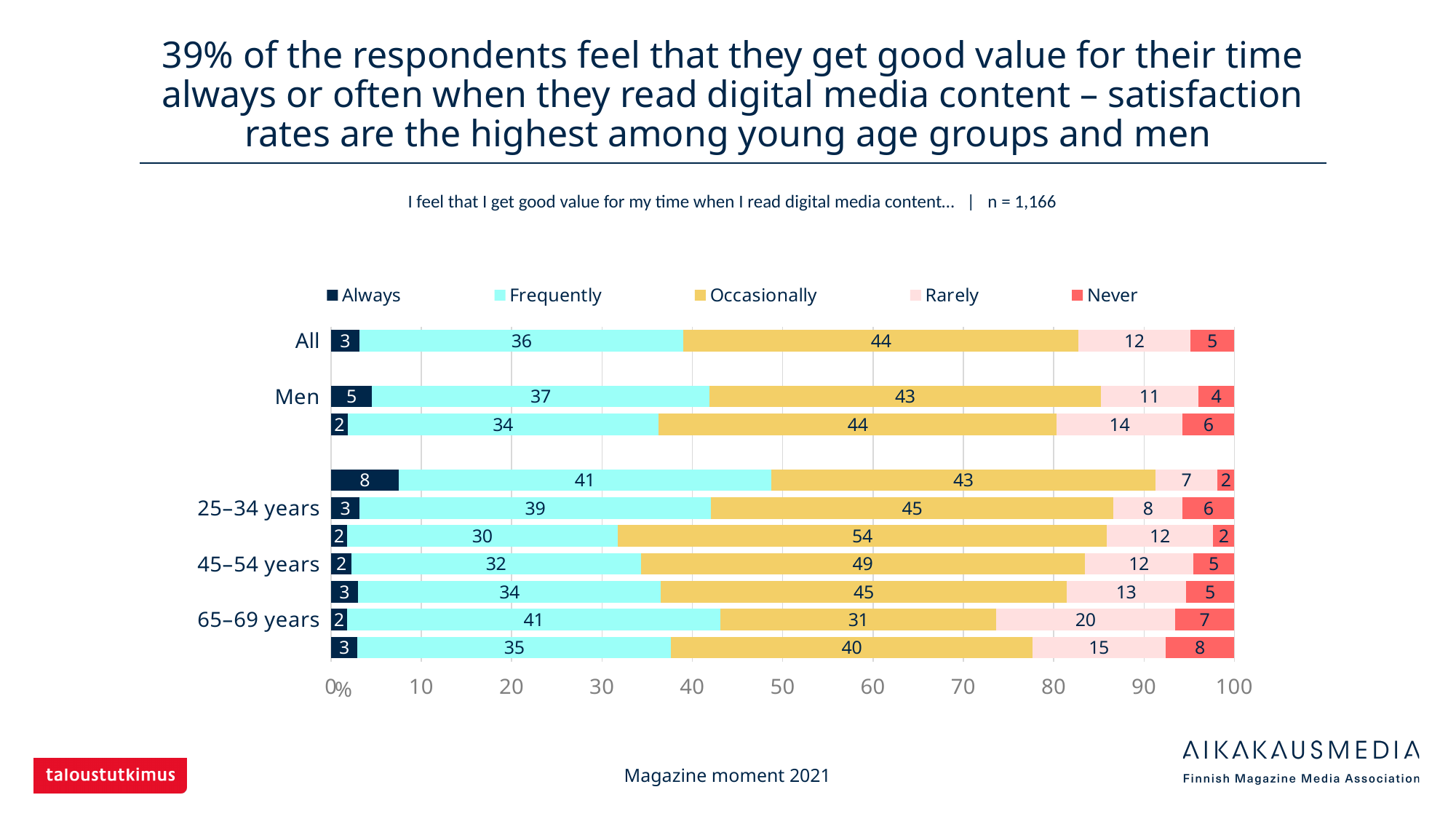
How many series does the legend list? 5 What is the value of the Always segment for Men? 5 What is the difference between the Occasionally values for 45–54 years and 65–69 years? 18 What is the value of the Never segment for 45–54 years? 5 What is the value of the Frequently segment for 25–34 years? 39 Which bar has the highest Rarely value? 65–69 years What is the value of the Rarely segment for 65–69 years? 20 What kind of chart is shown on the slide? Stacked bar chart What colour represents the Never series in the legend? Red Which has the larger Never value, Men or 25–34 years? 25–34 years What is the value of the Occasionally segment for the All bar? 44 What is the total of the All bar? 100